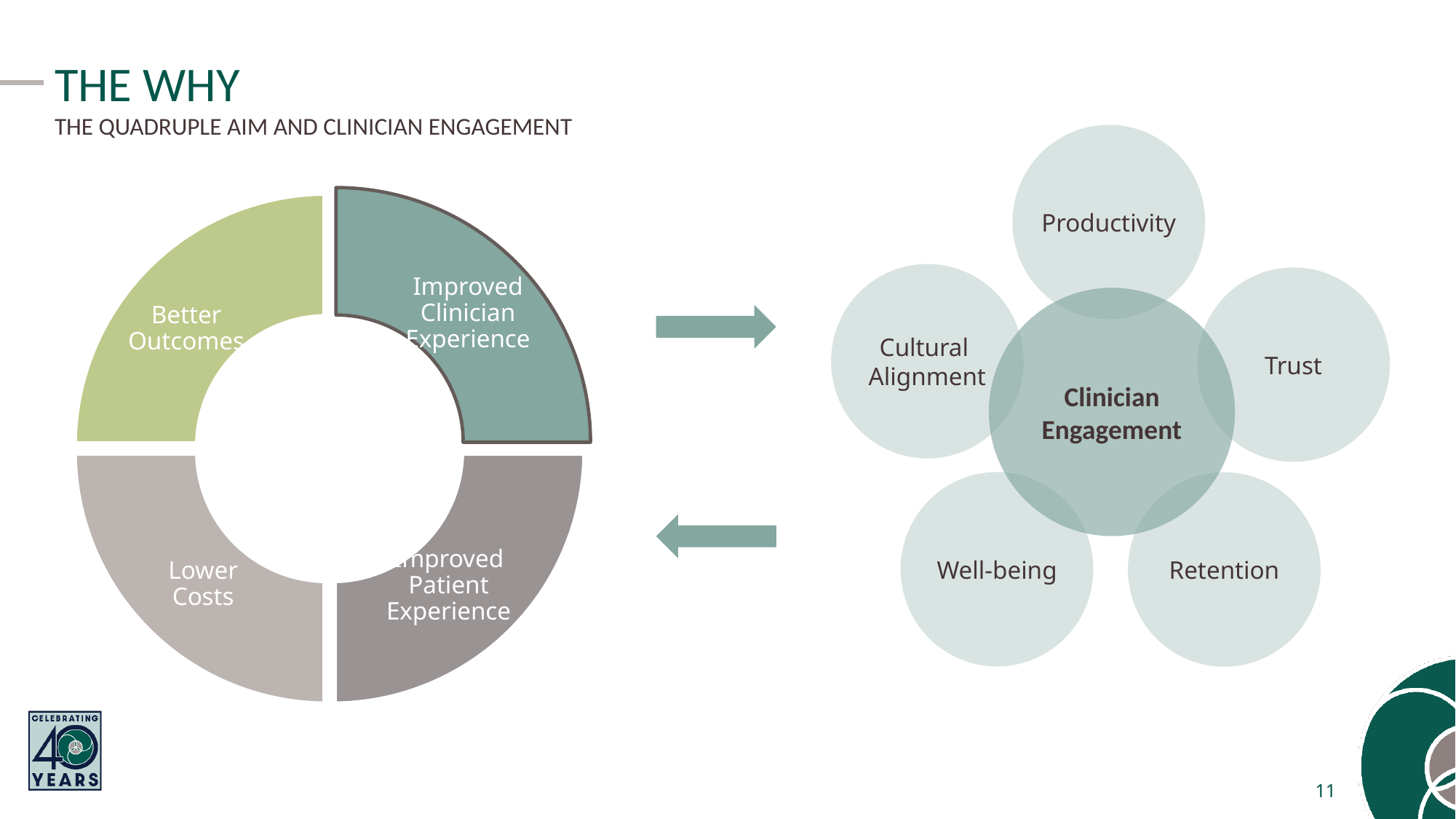
What is the label of the segment in the top-left quarter of the donut chart? Better Outcomes What kind of chart is shown on the left side of the slide? Donut chart Which segment of the donut chart is coloured green? Better Outcomes How many segments does the donut chart on the left have? 4 Which segment of the donut chart is drawn with a dark outline? Improved Clinician Experience What is the label of the segment in the bottom-right quarter of the donut chart? Improved Patient Experience What is the label of the segment in the top-right quarter of the donut chart? Improved Clinician Experience What is the label of the segment in the bottom-left quarter of the donut chart? Lower Costs